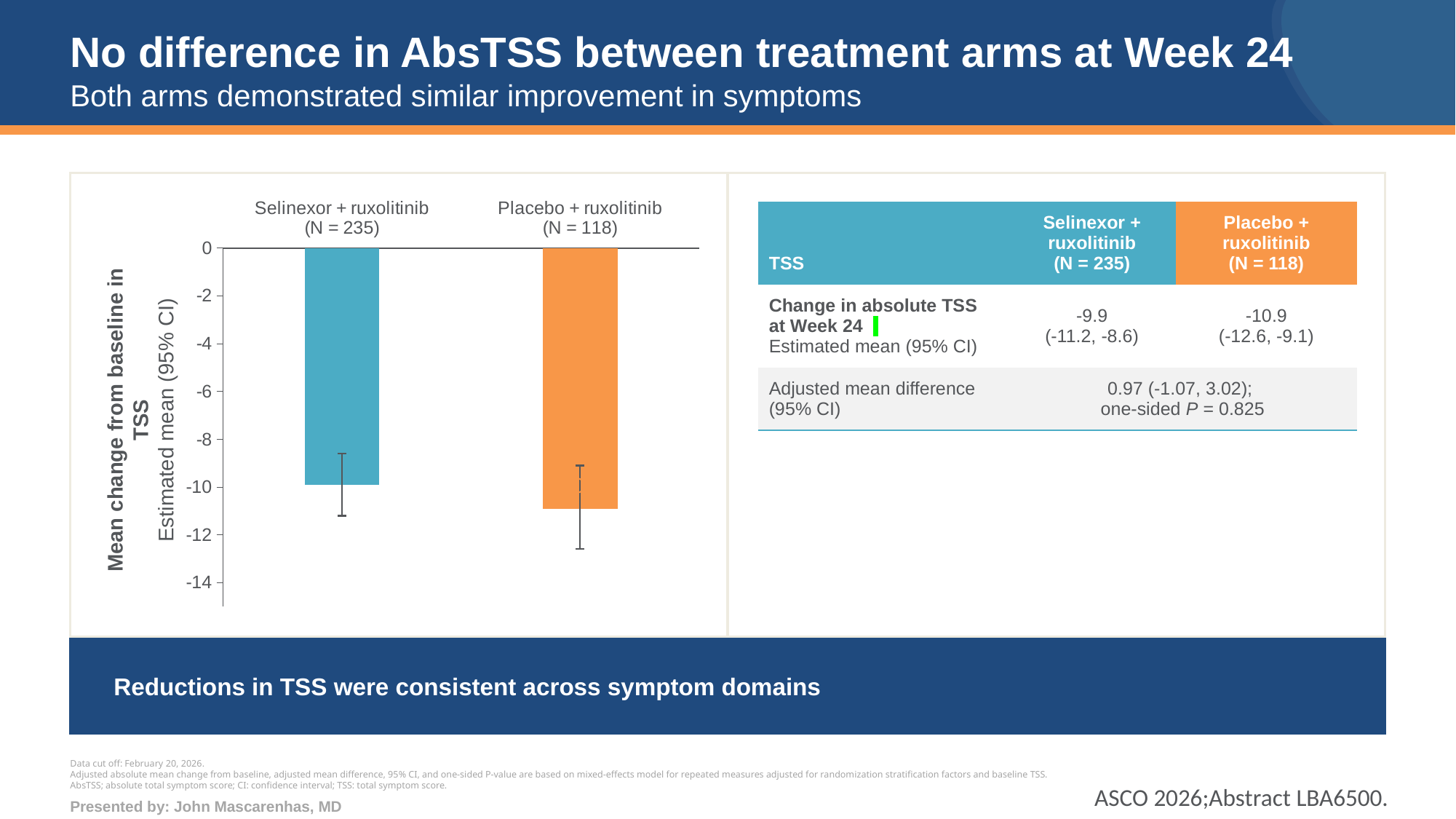
Which arm shows the larger (more negative) mean change from baseline in TSS? Placebo + ruxolitinib What is the sample size (N) shown for the Placebo + ruxolitinib arm in the chart? 118 What is the estimated mean change from baseline in TSS for the Placebo + ruxolitinib arm? -10.9 What colour is the bar for the Selinexor + ruxolitinib arm? blue What is the estimated mean change from baseline in TSS for the Selinexor + ruxolitinib arm? -9.9 What kind of chart is shown on the left of the slide? bar chart Is the bar for Placebo + ruxolitinib greater or less than -10 on the y axis? less How many bars (treatment arms) are plotted in the chart? 2 Is the bar for Selinexor + ruxolitinib greater or less than -8 on the y axis? less Which arm shows the smaller (less negative) mean change from baseline in TSS? Selinexor + ruxolitinib What is the lowest tick value shown on the y axis of the chart? -14